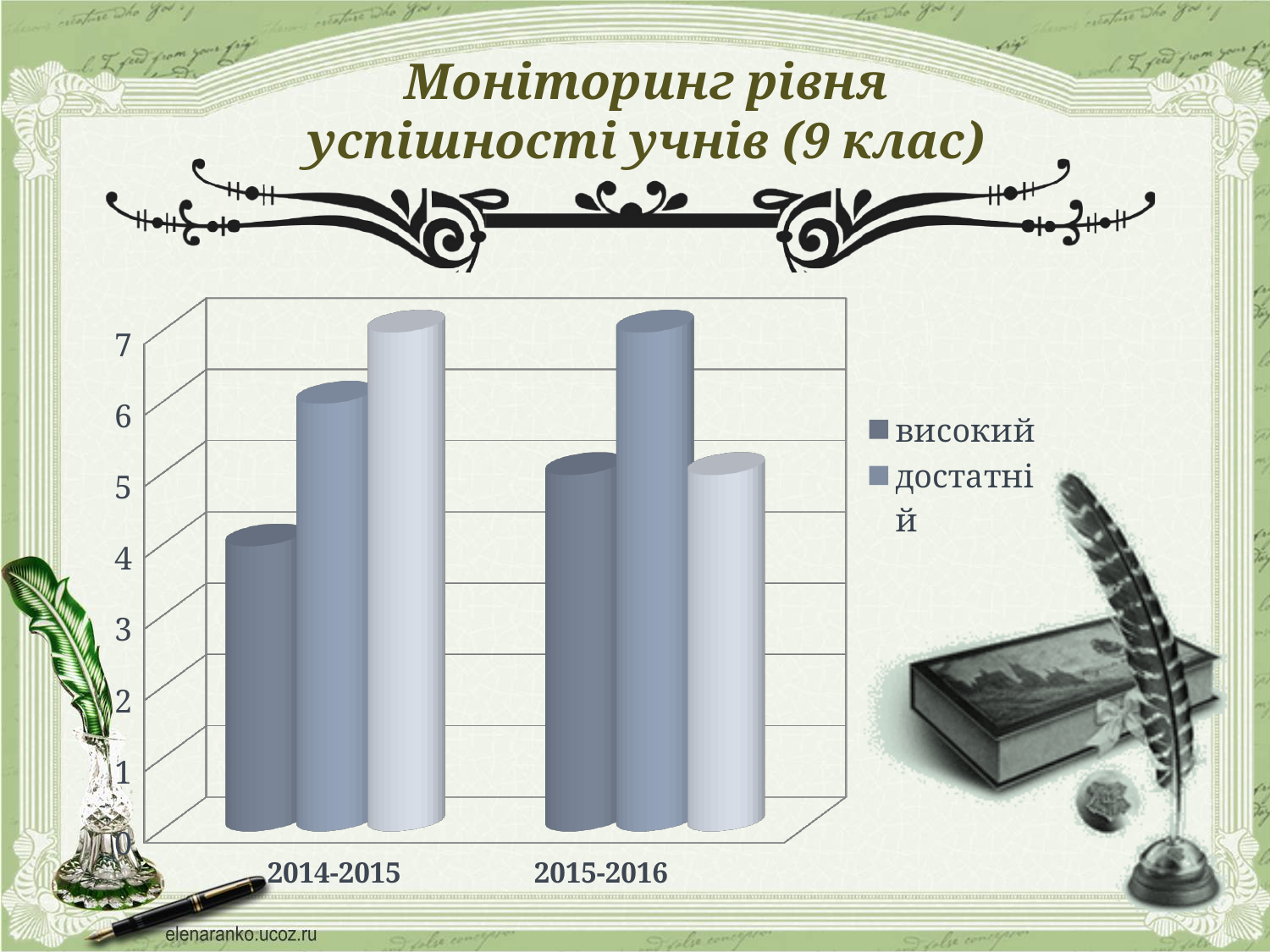
How many categories (school years) are shown on the x axis? 2 In the 2014-2015 group, which is taller: the first bar or the third bar? the third bar What is the first entry listed in the chart legend? високий Is the value of the first (leftmost) bar for 2015-2016 greater or less than 4? greater What kind of chart is shown on the slide? bar chart In the 2014-2015 group, which bar is the shortest? the first (leftmost) bar Is the value of the first (leftmost) bar for 2014-2015 greater or less than 5? less Which is taller: the middle bar for 2014-2015 or the middle bar for 2015-2016? the middle bar for 2015-2016 In the 2015-2016 group, which bar is the tallest? the middle bar Is the value of the third (rightmost) bar for 2014-2015 greater or less than 6? greater What is the title of the slide with the chart? Моніторинг рівня успішності учнів (9 клас)